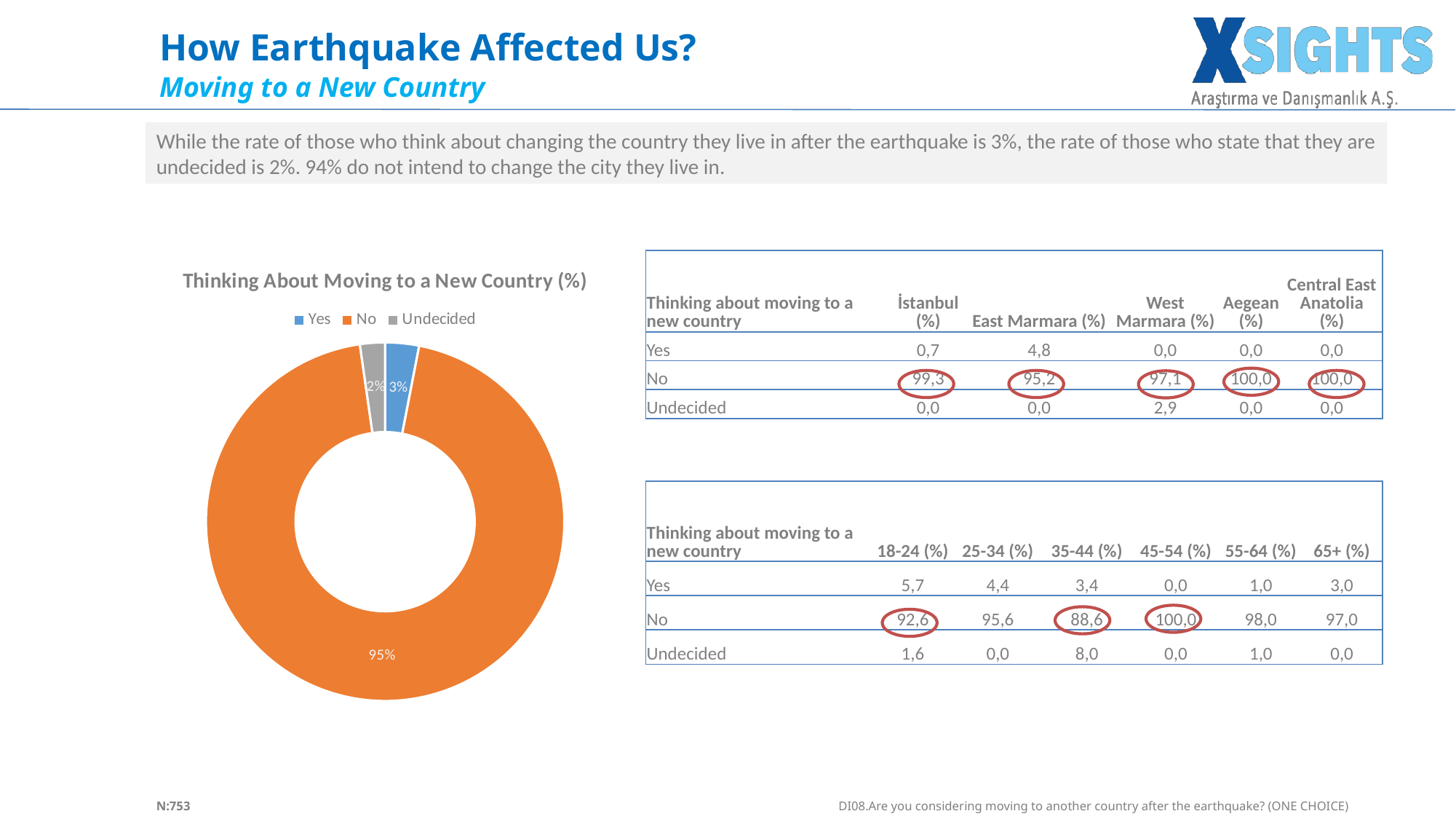
What is the value for "Yes" in the chart? 3% Which colour represents "No" in the chart? Orange Which category has the smallest share in the chart? Undecided How many slices does the donut chart have? 3 What is the difference between the "No" and "Yes" values in the chart? 92% How many categories does the chart's legend list? 3 What is the value for "Undecided" in the chart? 2% Which category has the largest share in the chart? No Which is larger in the chart, "Yes" or "Undecided"? Yes What is the title of the chart? Thinking About Moving to a New Country (%) What kind of chart is shown on the slide? Donut (pie) chart What is the value for "No" in the chart? 95%